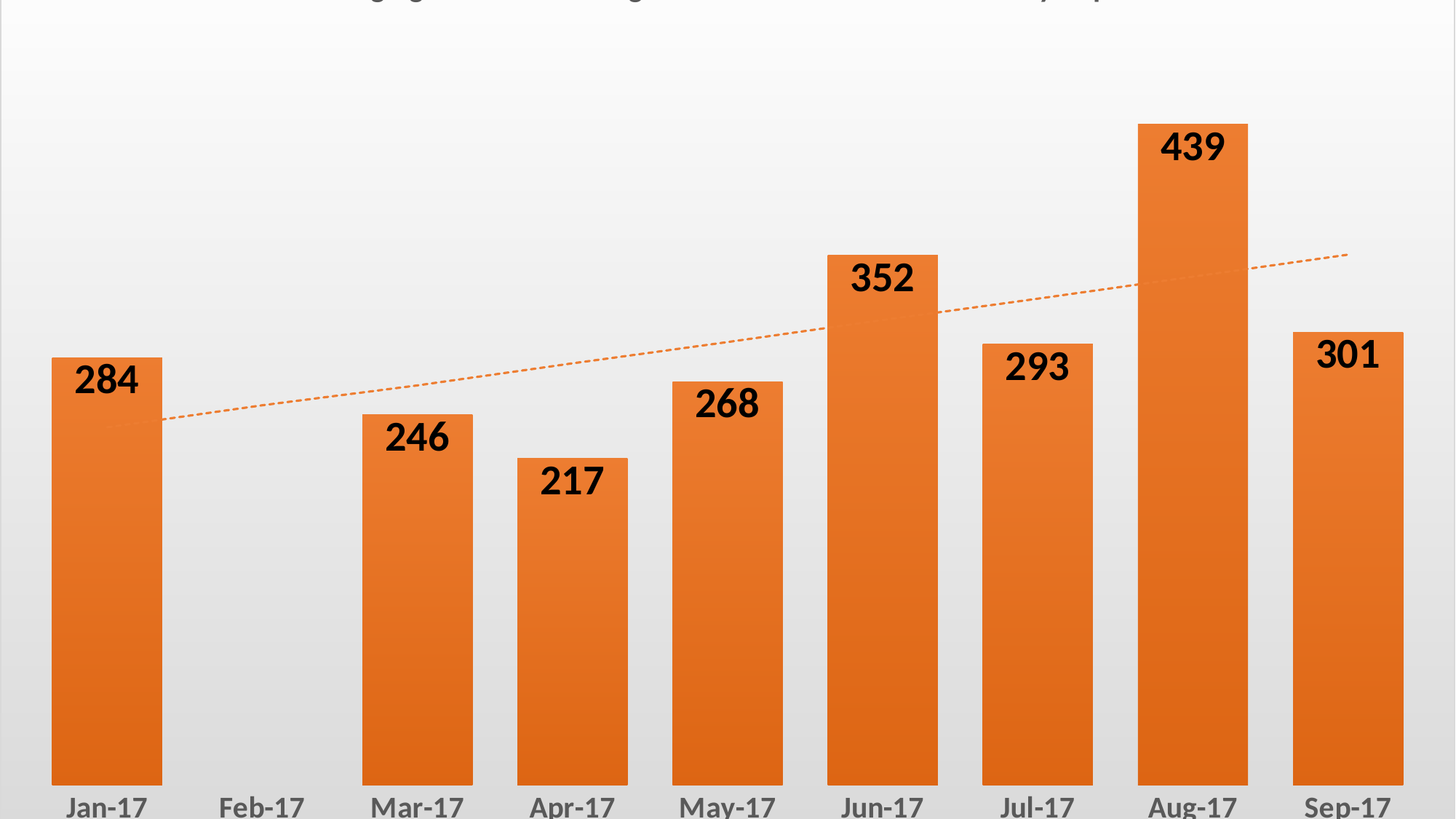
What kind of chart is shown on the slide? Bar chart Which month with a bar has the lowest value? Apr-17 Which month has the highest value? Aug-17 What is the value for Jun-17? 352 What is the value for Aug-17? 439 What is the difference between the values for Aug-17 and Jul-17? 146 Which month on the x axis has no bar plotted? Feb-17 How many months are labelled on the x axis? 9 What is the value for Apr-17? 217 What is the value for Sep-17? 301 Which is larger, the value for May-17 or the value for Jul-17? Jul-17 What is the difference between the values for Jan-17 and Mar-17? 38